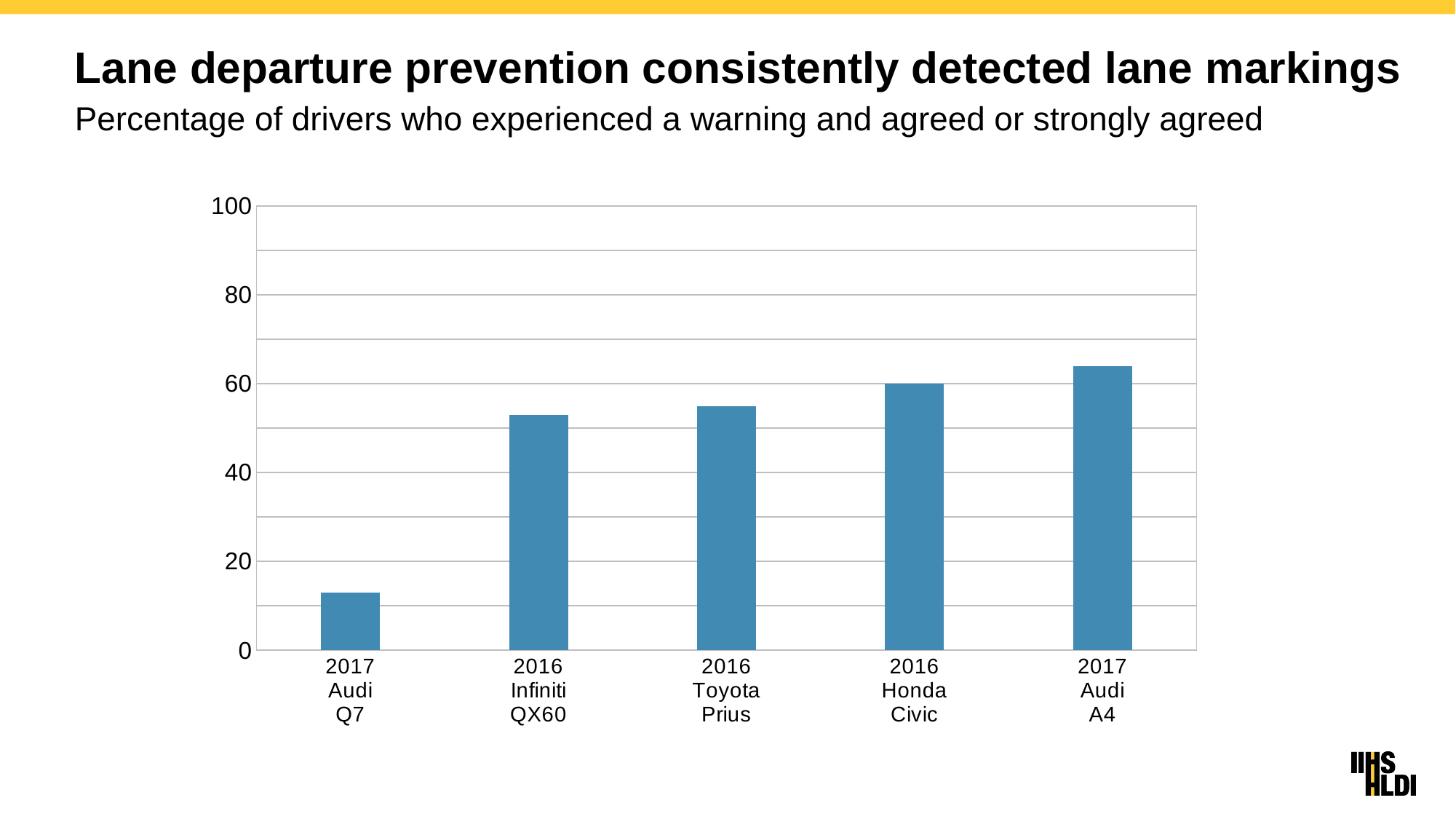
How many vehicles are shown on the x axis of the chart? 5 Which vehicle has the lowest percentage of drivers who agreed or strongly agreed? 2017 Audi Q7 What is the title of the slide? Lane departure prevention consistently detected lane markings Which has a higher value, the 2016 Honda Civic or the 2016 Infiniti QX60? 2016 Honda Civic Which has a higher value, the 2017 Audi A4 or the 2017 Audi Q7? 2017 Audi A4 Do the bar values rise or fall from left to right along the x axis? rise Is the value for the 2016 Toyota Prius greater or less than 60? less Which vehicle has the highest percentage of drivers who agreed or strongly agreed? 2017 Audi A4 What kind of chart is shown on the slide? bar chart Is the value for the 2016 Infiniti QX60 greater or less than 40? greater Is the value for the 2017 Audi A4 greater or less than 60? greater